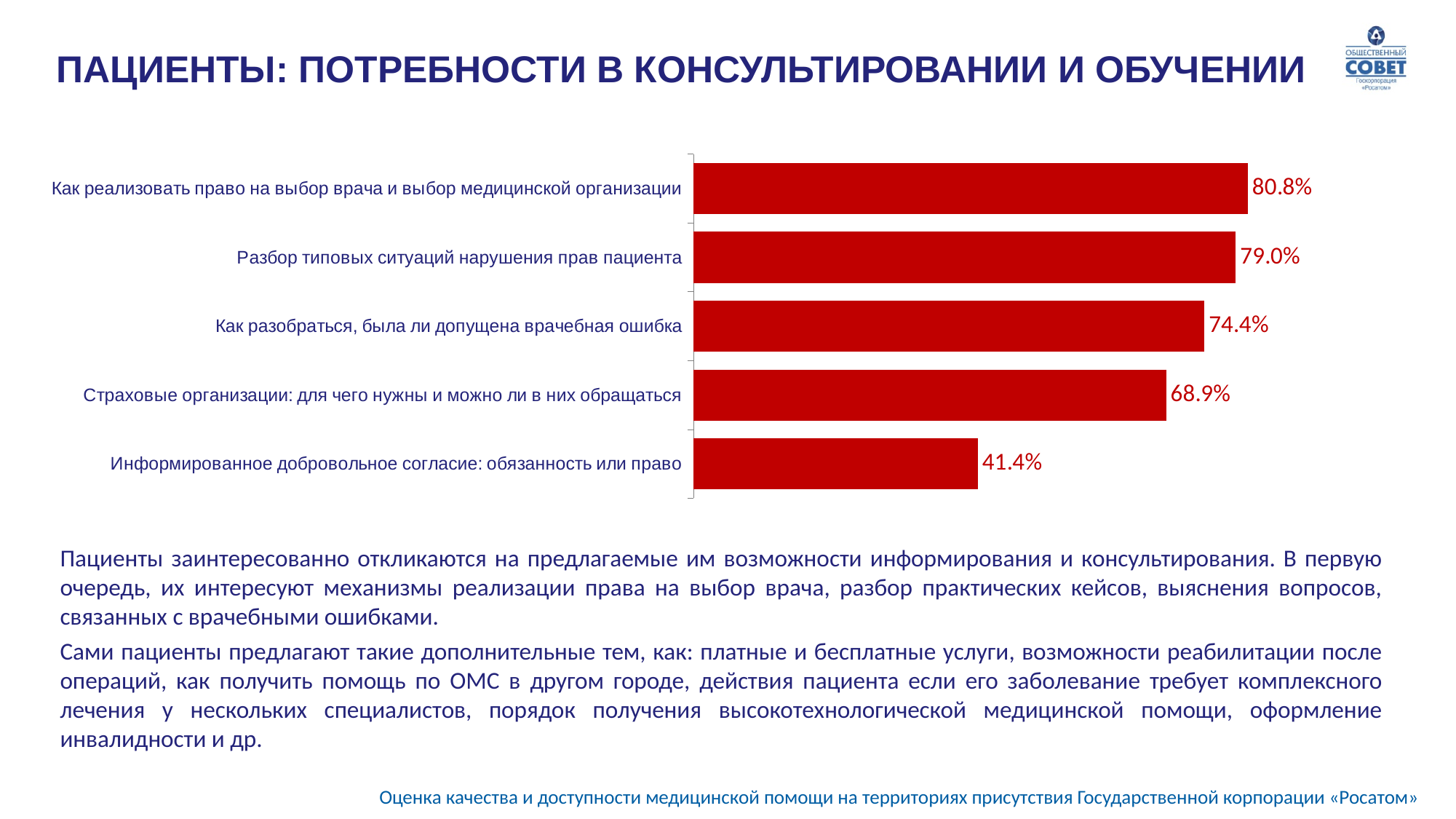
What kind of chart is shown on the slide? Bar chart What is the difference between the values for «Как разобраться, была ли допущена врачебная ошибка» and «Страховые организации: для чего нужны и можно ли в них обращаться»? 5.5% What is the value for «Страховые организации: для чего нужны и можно ли в них обращаться»? 68.9% What is the value for «Как разобраться, была ли допущена врачебная ошибка»? 74.4% What is the difference between the values for «Как реализовать право на выбор врача и выбор медицинской организации» and «Информированное добровольное согласие: обязанность или право»? 39.4% What is the value for «Разбор типовых ситуаций нарушения прав пациента»? 79.0% What is the value for «Как реализовать право на выбор врача и выбор медицинской организации»? 80.8% Which category has the highest value? Как реализовать право на выбор врача и выбор медицинской организации How many categories are shown in the chart? 5 Which category has the lowest value? Информированное добровольное согласие: обязанность или право Which is larger: the value for «Разбор типовых ситуаций нарушения прав пациента» or for «Страховые организации: для чего нужны и можно ли в них обращаться»? Разбор типовых ситуаций нарушения прав пациента What is the value for «Информированное добровольное согласие: обязанность или право»? 41.4%